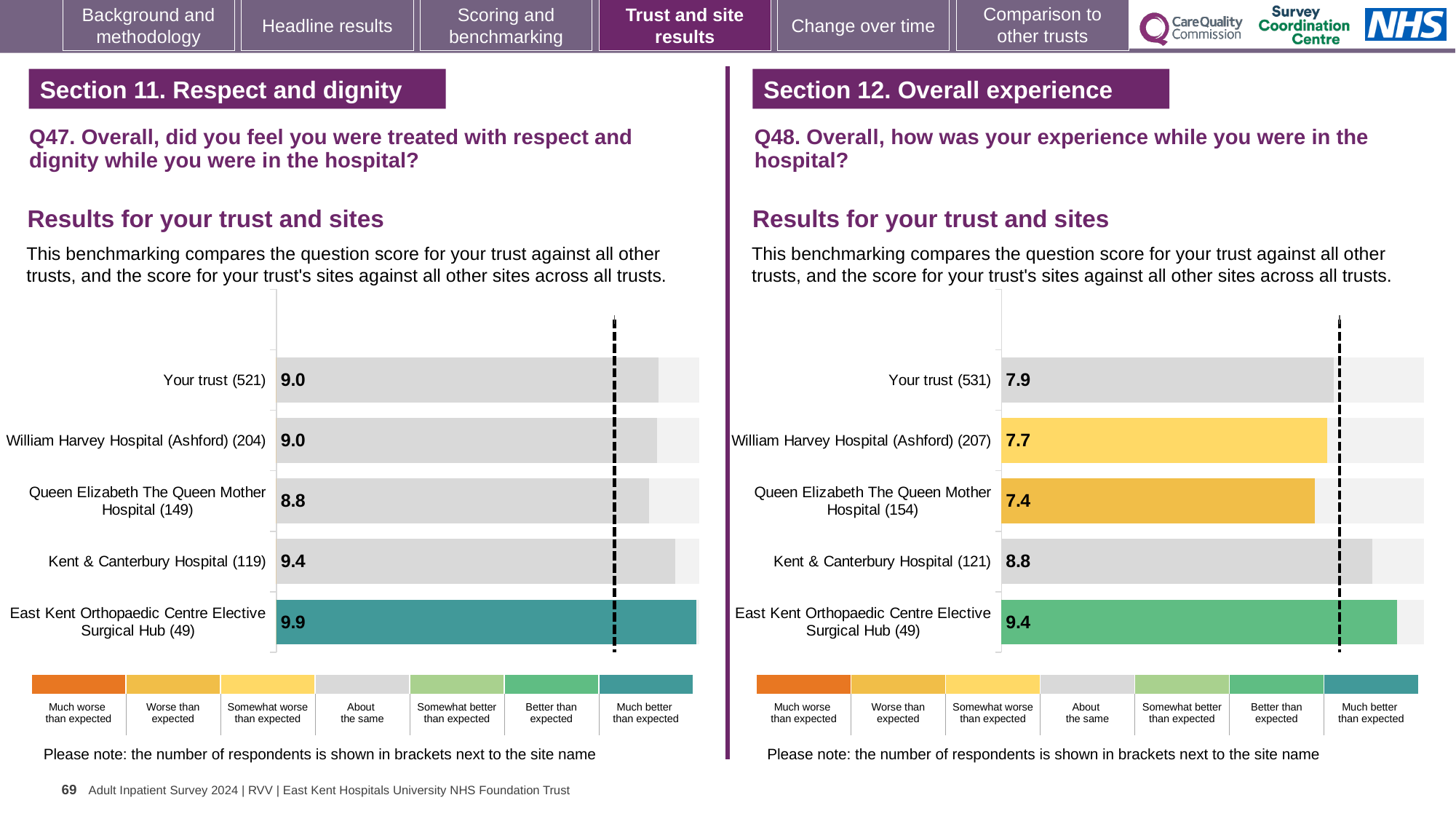
On the Q48 chart (right), which is larger: the score for Kent & Canterbury Hospital or the score for William Harvey Hospital (Ashford)? Kent & Canterbury Hospital On the Q48 chart (right), what is the score for Queen Elizabeth The Queen Mother Hospital? 7.4 On the Q47 chart (left), what is the score for Kent & Canterbury Hospital? 9.4 On the Q48 chart (right), what is the score for Your trust? 7.9 On the Q47 chart (left), what is the difference between the East Kent Orthopaedic Centre Elective Surgical Hub score and the Your trust score? 0.9 What type of chart is used on the Q47 chart (left)? Bar chart On the Q48 chart (right), what is the difference between the Kent & Canterbury Hospital score and the Queen Elizabeth The Queen Mother Hospital score? 1.4 On the Q48 chart (right), which site has the lowest score? Queen Elizabeth The Queen Mother Hospital On the Q47 chart (left), how many bars are plotted? 5 On the Q47 chart (left), which site has the highest score? East Kent Orthopaedic Centre Elective Surgical Hub On the Q48 chart (right), which site has the highest score? East Kent Orthopaedic Centre Elective Surgical Hub On the Q47 chart (left), which site has the lowest score? Queen Elizabeth The Queen Mother Hospital